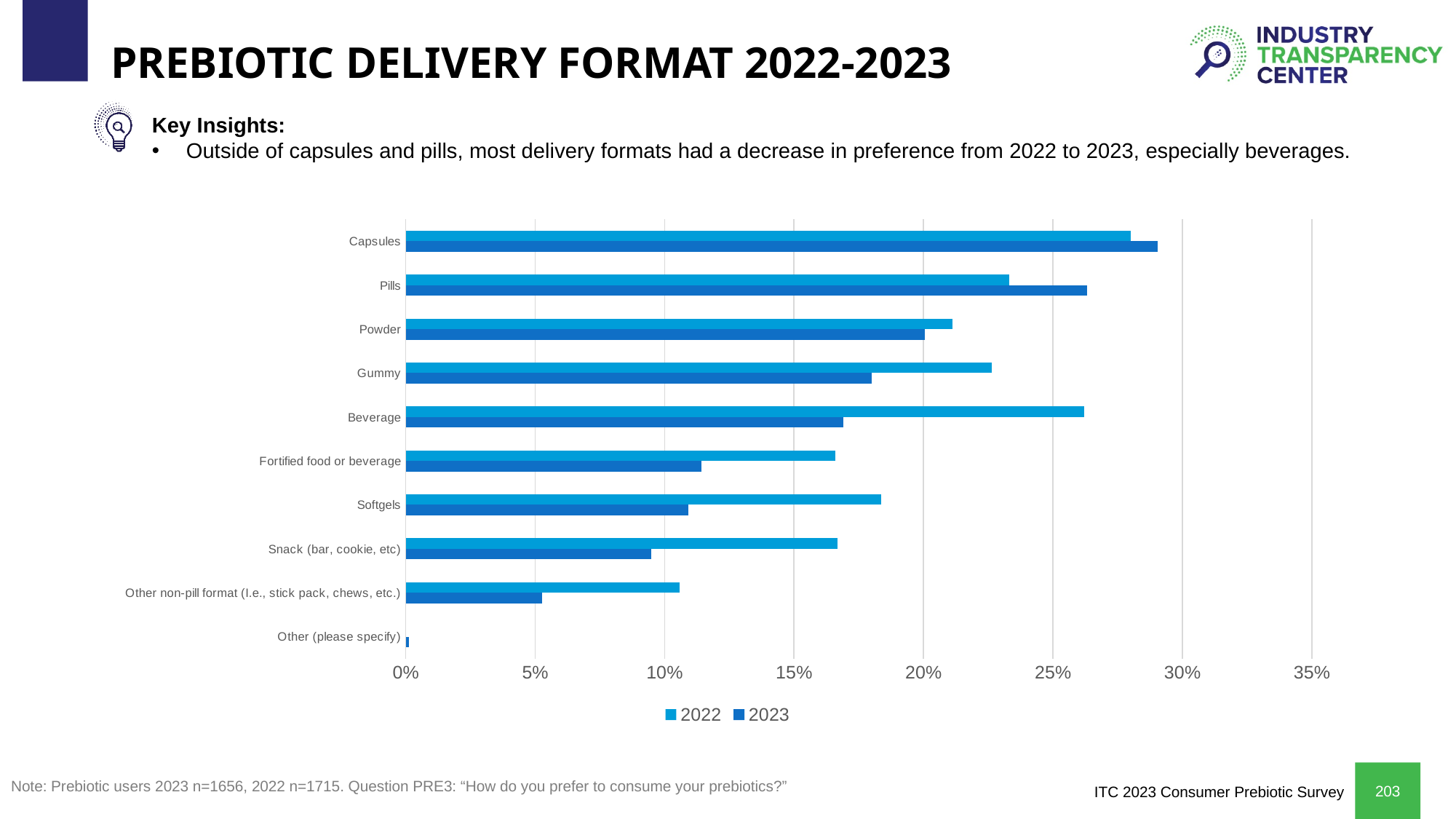
Which delivery format has the highest value for 2022? Capsules Is the 2023 value for Beverage greater or less than 20%? less Is the 2023 value for Snack (bar, cookie, etc) greater or less than 10%? less Is the 2022 value for Beverage greater or less than 25%? greater Which delivery format has the lowest value for 2023? Other (please specify) For Pills, which year has the larger value, 2022 or 2023? 2023 What kind of chart is shown on the slide? bar chart Which delivery format has the highest value for 2023? Capsules For Beverage, which year has the larger value, 2022 or 2023? 2022 What are the two series named in the legend? 2022 and 2023 How many series does the legend list? 2 How many delivery format categories are plotted on the chart? 10